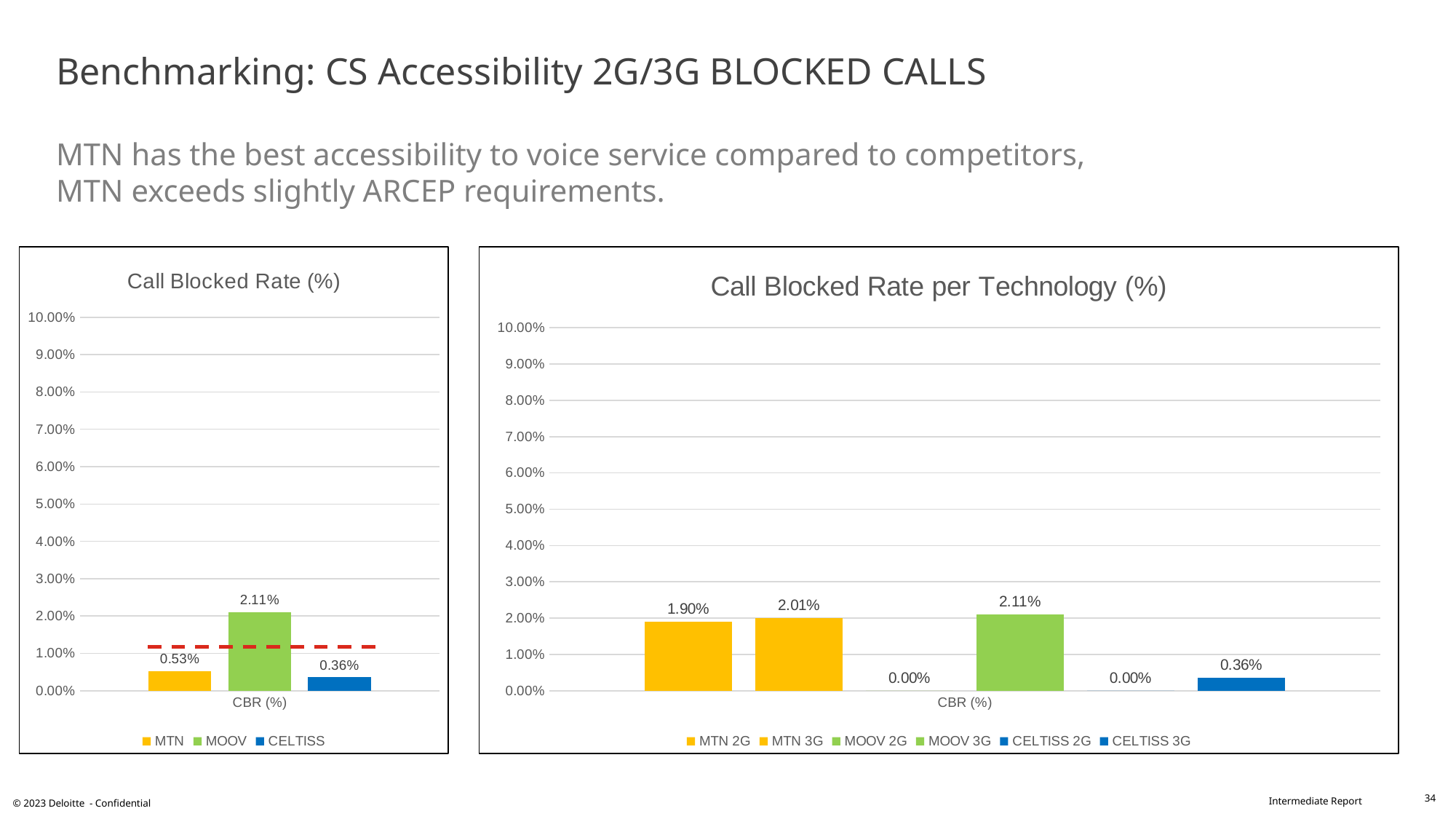
In the 'Call Blocked Rate per Technology (%)' chart, what is the value for MTN 3G? 2.01% In the 'Call Blocked Rate (%)' chart, what is the value for CELTISS? 0.36% What kind of chart is the 'Call Blocked Rate per Technology (%)' chart? Bar chart In the 'Call Blocked Rate (%)' chart, which operator has the highest call blocked rate? MOOV In the 'Call Blocked Rate per Technology (%)' chart, which is larger, MTN 2G or MTN 3G? MTN 3G In the 'Call Blocked Rate (%)' chart, what is the difference between the MOOV and MTN values? 1.58% In the 'Call Blocked Rate (%)' chart, how many series does the legend list? 3 In the 'Call Blocked Rate per Technology (%)' chart, which series has the highest value? MOOV 3G In the 'Call Blocked Rate (%)' chart, which operator has the lowest call blocked rate? CELTISS In the 'Call Blocked Rate per Technology (%)' chart, what is the value for MTN 2G? 1.90% In the 'Call Blocked Rate (%)' chart, what is the value for MOOV? 2.11% In the 'Call Blocked Rate per Technology (%)' chart, how many series does the legend list? 6